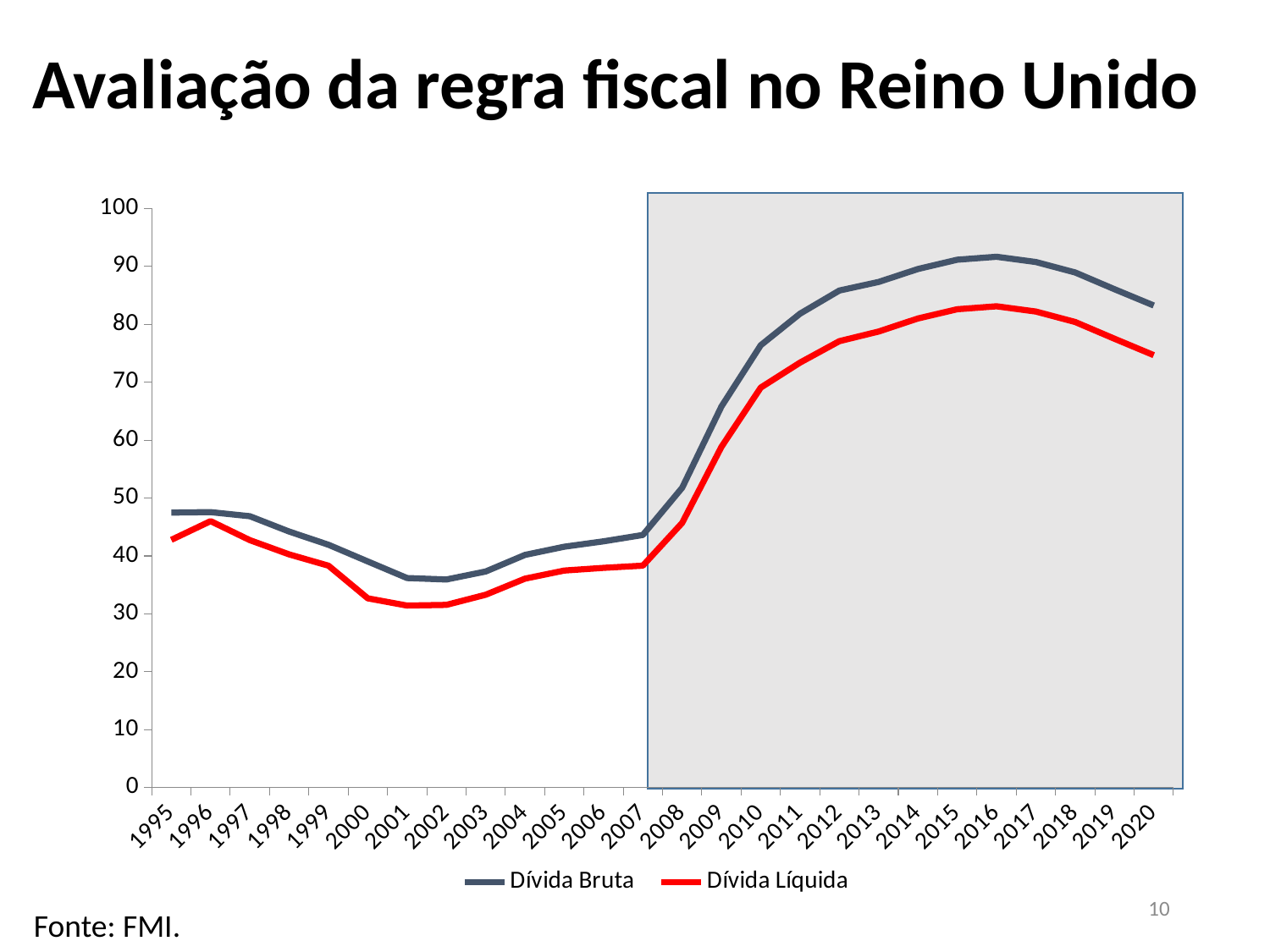
Do the values for Dívida Bruta rise or fall between 2008 and 2014? rise Is the value for Dívida Líquida in 2020 greater or less than 70? greater How many series does the legend list? 2 Is the value for Dívida Bruta in 2001 greater or less than 40? less Is the value for Dívida Líquida in 2016 greater or less than 80? greater Which series has the larger value in 2010, Dívida Bruta or Dívida Líquida? Dívida Bruta What kind of chart is shown on the slide? line chart Do the values for Dívida Líquida rise or fall between 1996 and 2001? fall How many years are plotted along the x axis? 26 What colour is the Dívida Líquida line? red